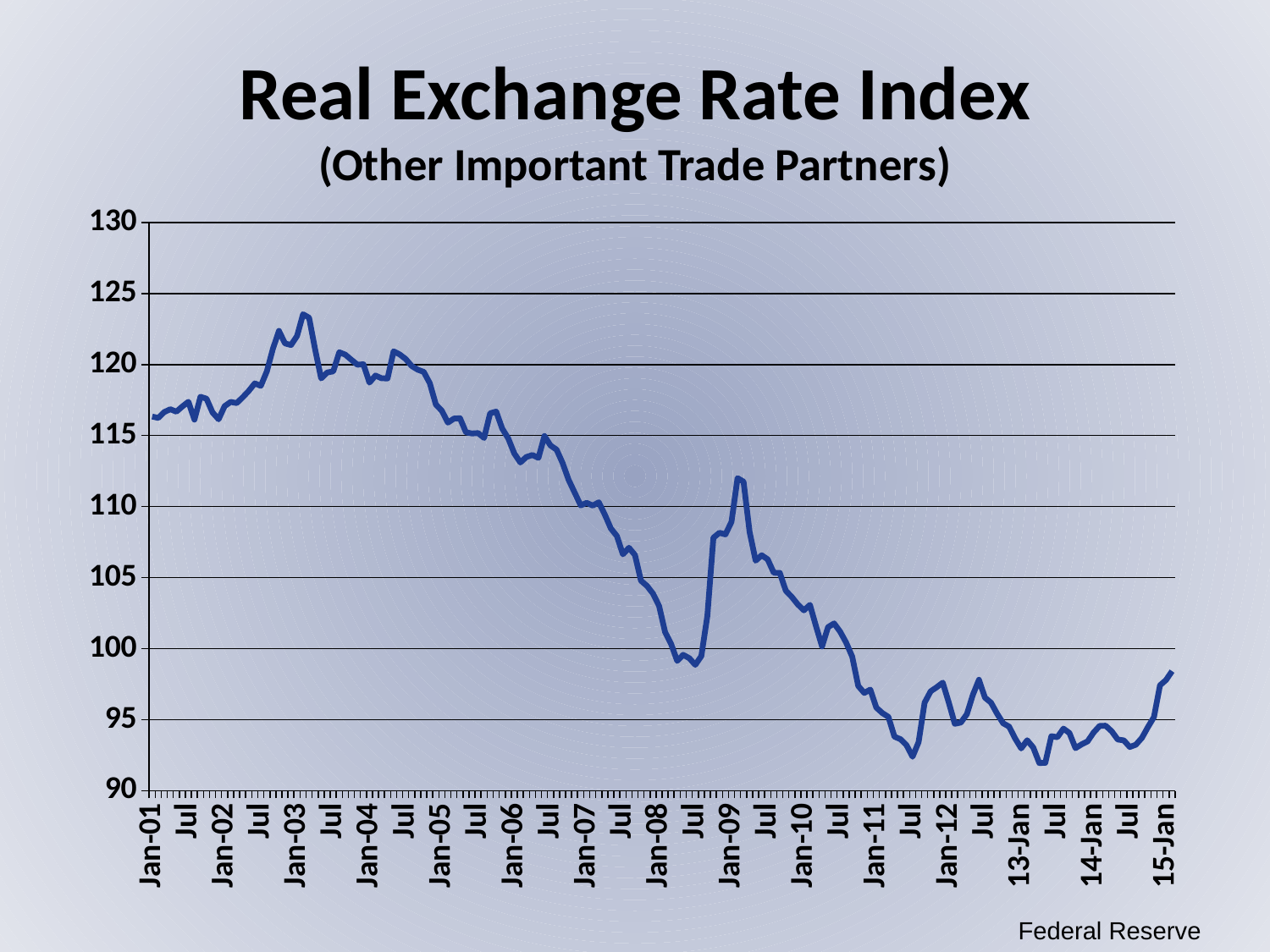
Does the index generally rise or fall from Jan-01 to 15-Jan? fall Is the value at 15-Jan greater or less than 95? greater What kind of chart is shown on the slide? line chart Which is larger, the value at Jan-03 or the value at Jan-09? Jan-03 Is the value at Jan-03 greater or less than 120? greater What is the title of the chart? Real Exchange Rate Index (Other Important Trade Partners) What source is cited for the chart data? Federal Reserve Is the value at Jan-01 greater or less than 115? greater